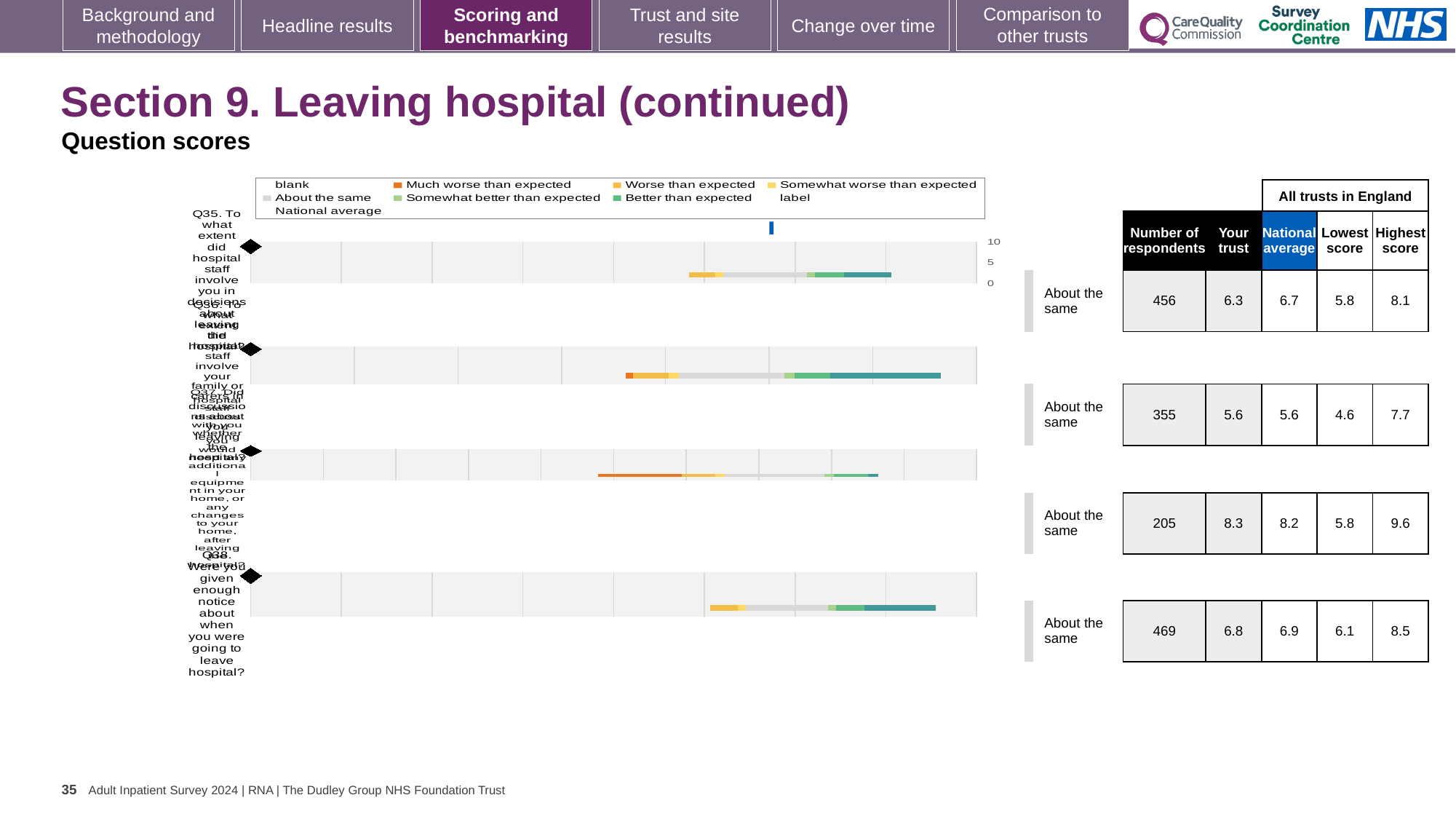
What is the difference between the highest score and the lowest score for the first row (Q35)? 2.3 How many question rows (bars) are plotted in the chart? 4 In the table beside the chart, what is the national average for the second row? 5.6 In the table beside the chart, what is the lowest score for the last row (Q38)? 6.1 What kind of chart is shown on the slide? bar chart For the last row (Q38), which is larger: the 'Your trust' score or the national average? National average (6.9) Which row in the table has the fewest respondents? the third row (205) Which row in the table has the highest 'Your trust' score? the third row (8.3) What benchmark category is shown next to each of the four rows? About the same In the table beside the chart, what is the 'Your trust' score for the first row (Q35)? 6.3 In the table beside the chart, what is the number of respondents for the first row (Q35)? 456 In the table beside the chart, what is the highest score for the third row? 9.6